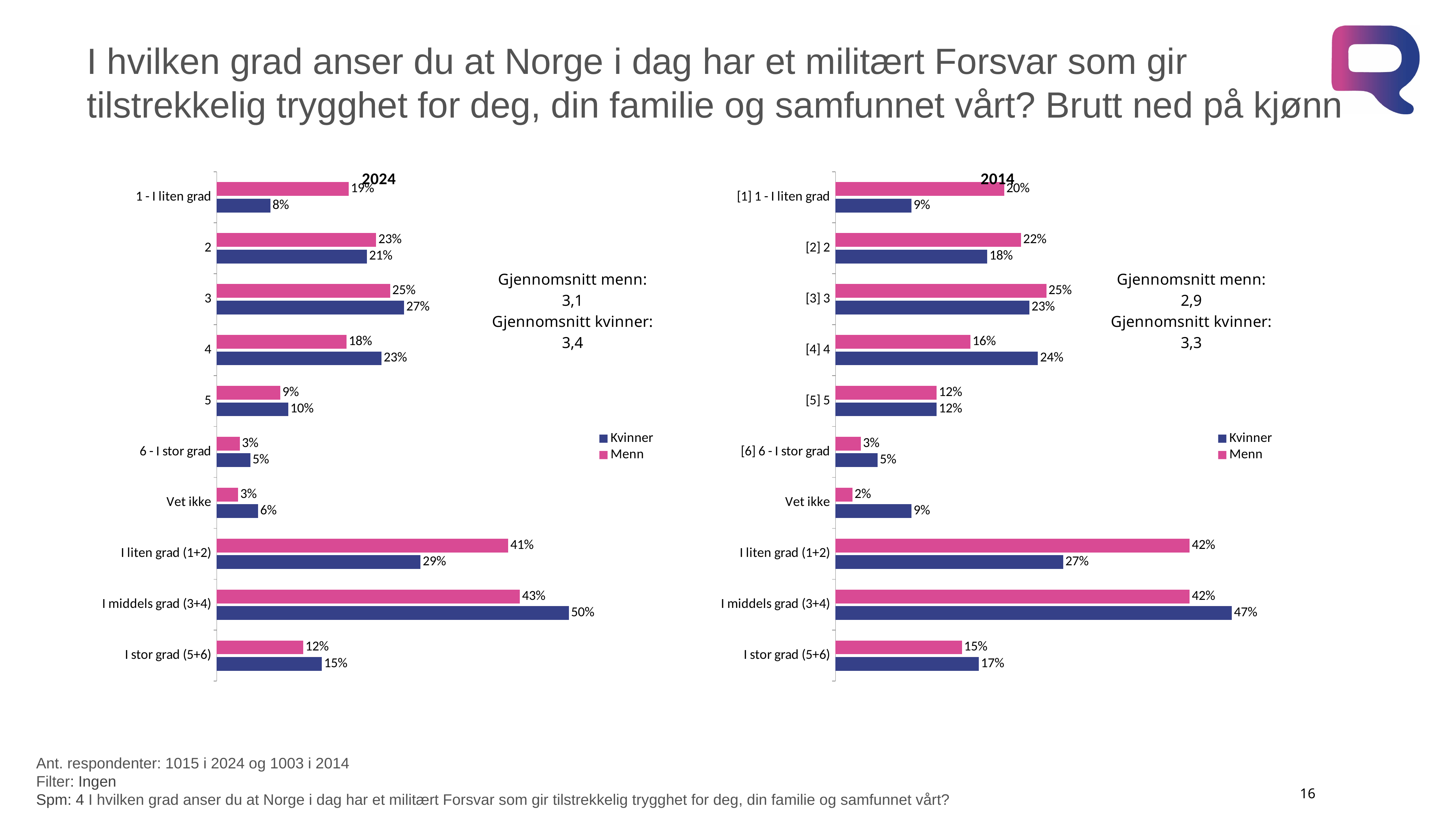
In the 2024 chart, what is the value for Kvinner in the category "I middels grad (3+4)"? 50% In the 2024 chart, which category has the highest value for Kvinner? I middels grad (3+4) In the 2014 chart, what is the value for Kvinner in the category "Vet ikke"? 9% In the 2014 chart, which is larger for "I middels grad (3+4)": Kvinner or Menn? Kvinner In the 2024 chart, what is the difference between Menn and Kvinner for "I liten grad (1+2)"? 12% In the 2024 chart, what is the value for Menn in the category "1 - I liten grad"? 19% How many series does the legend of the 2024 chart list? 2 In the 2014 chart, what is the difference between Kvinner and Menn for "[1] 1 - I liten grad"? 11% In the 2014 chart, what is the value for Menn in the category "[4] 4"? 16% In the 2014 chart, which category has the lowest value for Menn? Vet ikke How many categories are shown on the 2014 chart? 10 What kind of chart is the 2024 chart? Bar chart